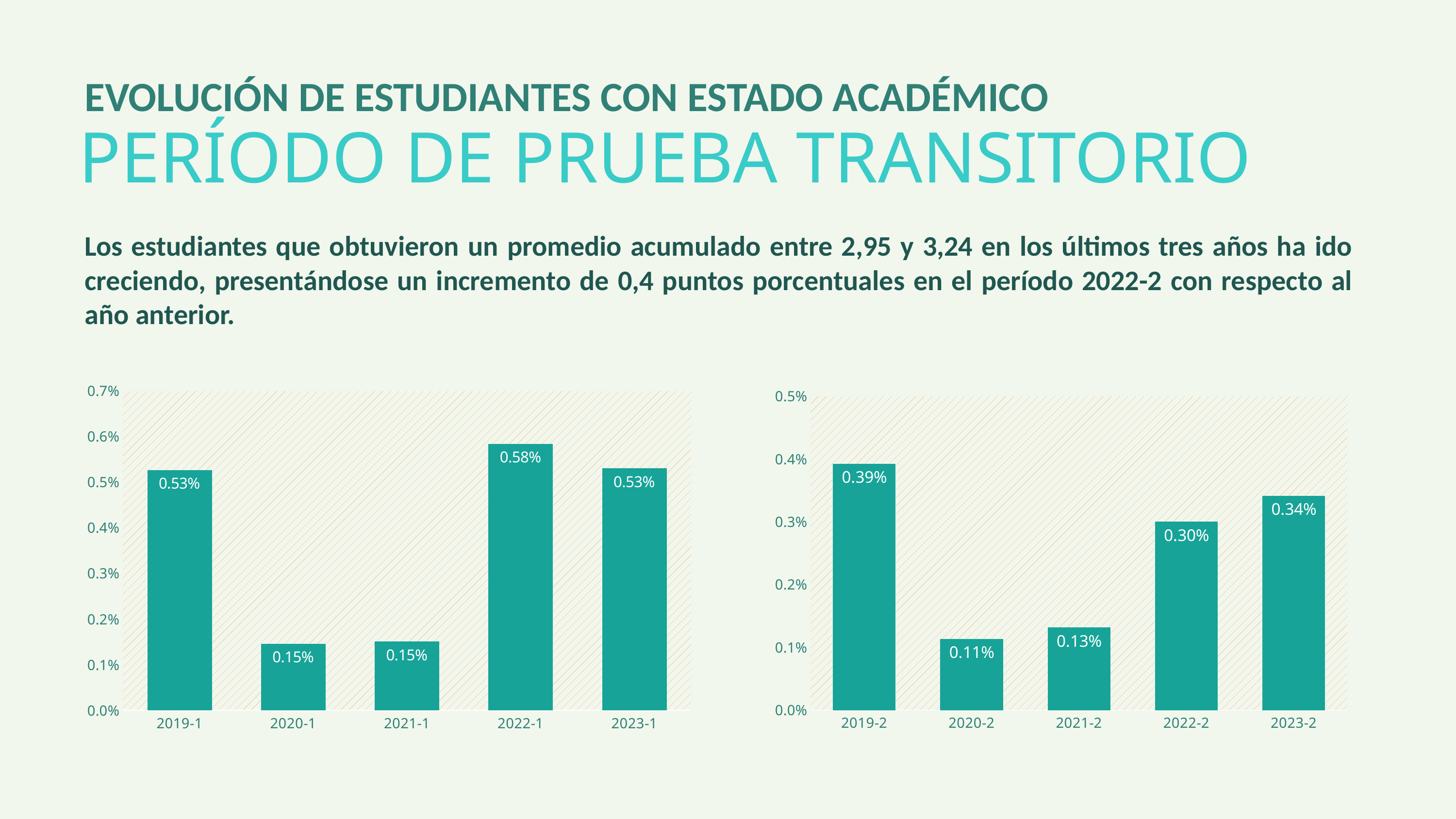
What type of chart is the left chart? bar chart In the left chart, what is the value for 2022-1? 0.58% In the right chart, which period has the lowest value? 2020-2 In the left chart, is the value for 2023-1 greater or less than 0.4%? greater How many periods are shown on the x axis of the right chart? 5 In the right chart, what is the value for 2020-2? 0.11% In the left chart, what is the difference between the values for 2022-1 and 2021-1? 0.43% In the right chart, what is the difference between the values for 2023-2 and 2022-2? 0.04% In the right chart, which period has the highest value? 2019-2 In the left chart, which period has the highest value? 2022-1 In the right chart, which is larger, the value for 2019-2 or the value for 2023-2? 2019-2 In the right chart, do the values rise or fall from 2020-2 to 2023-2? rise